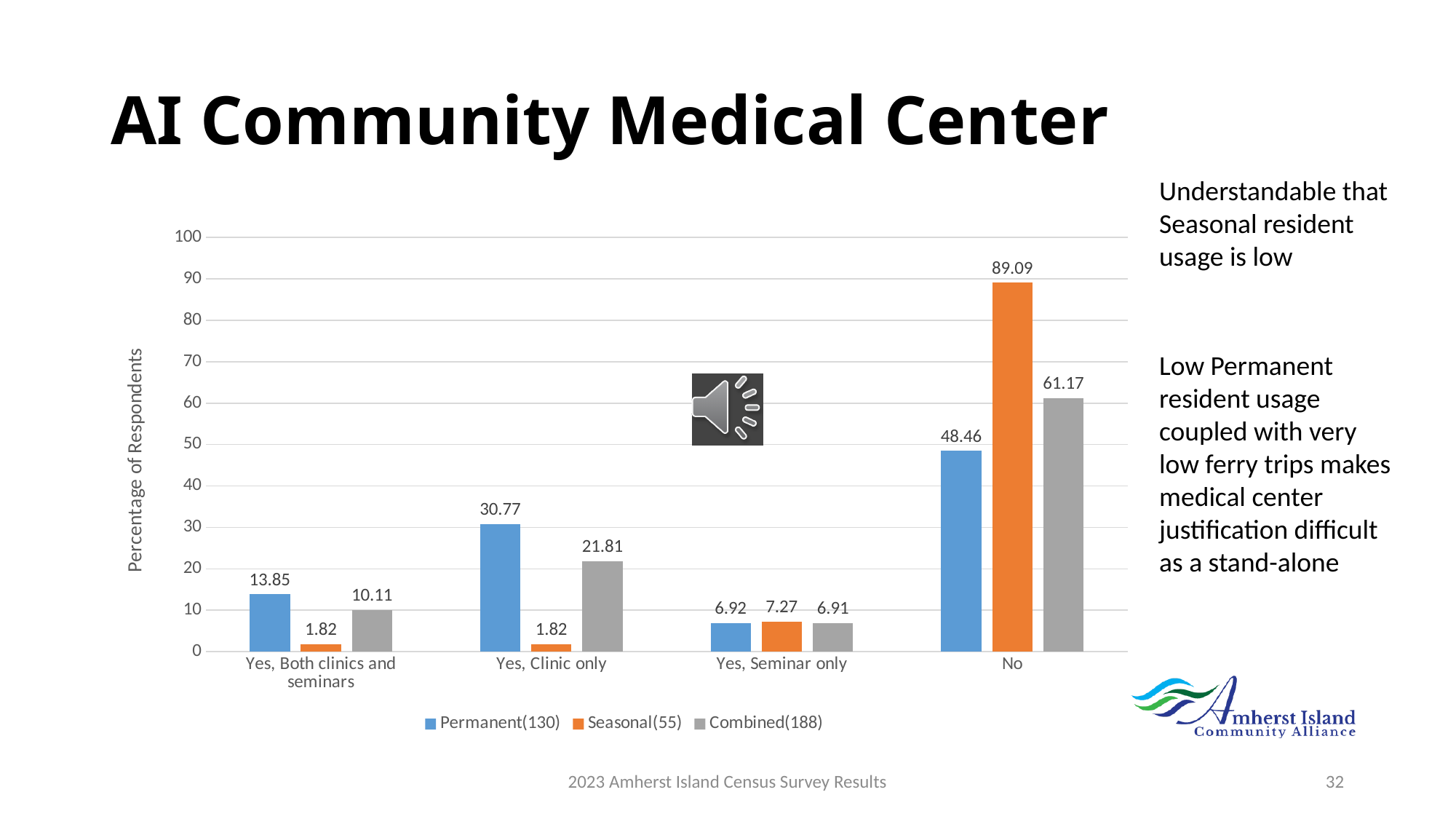
What is the value for Combined(188) in the 'Yes, Both clinics and seminars' category? 10.11 Is the Combined(188) value for 'No' greater or less than 50? greater What is the value for Seasonal(55) in the 'No' category? 89.09 How many series does the legend list? 3 Which category has the highest value for Permanent(130)? No How many categories are shown on the x axis? 4 Which category has the lowest value for Combined(188)? Yes, Seminar only What kind of chart is shown on the slide? Bar chart What is the label of the y axis? Percentage of Respondents What is the value for Permanent(130) in the 'Yes, Clinic only' category? 30.77 What is the difference between the Seasonal(55) and Permanent(130) values in the 'No' category? 40.63 Which is larger in the 'Yes, Clinic only' category: Permanent(130) or Combined(188)? Permanent(130)